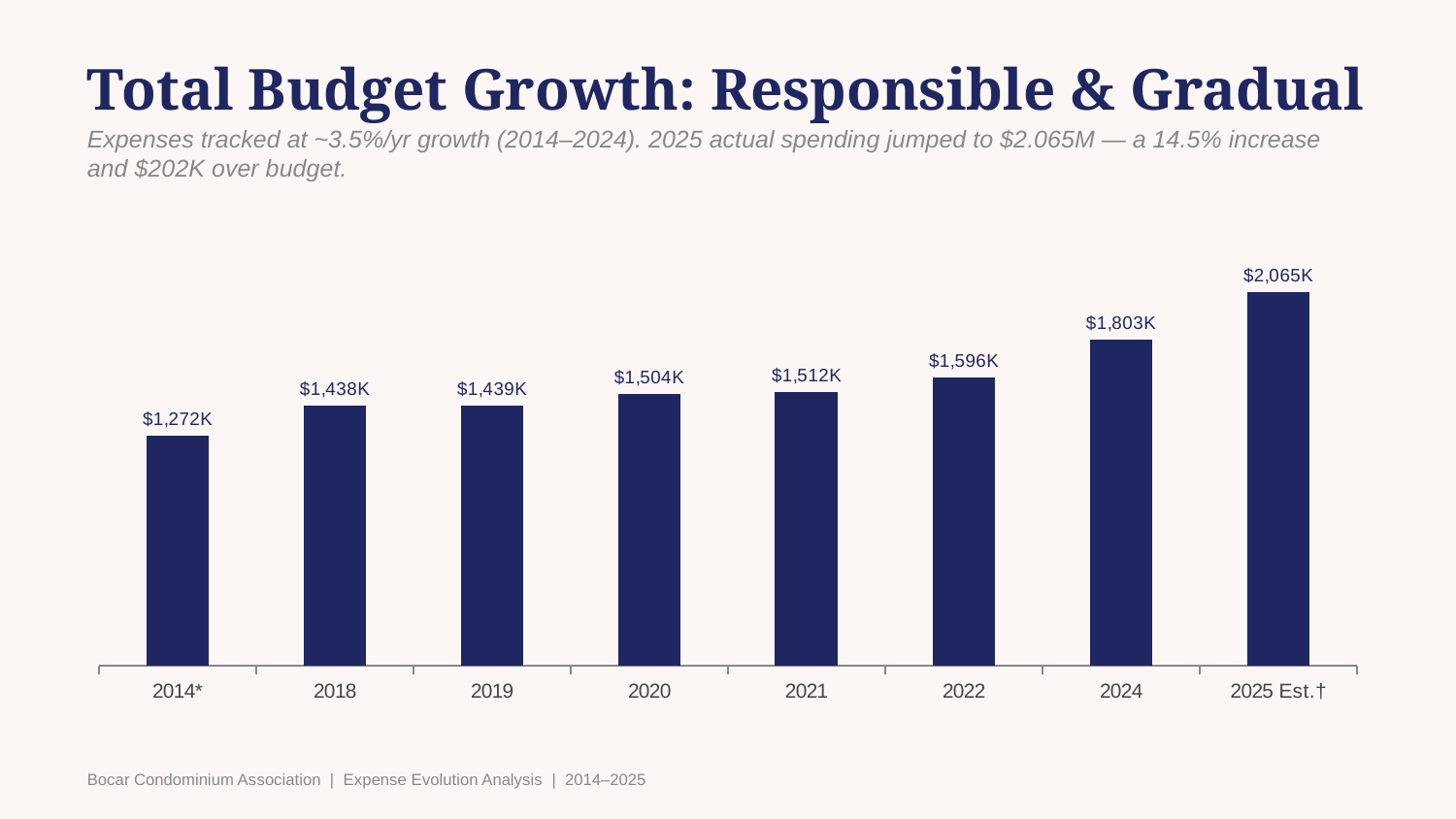
Do the values rise or fall from 2014* to 2025 Est.†? Rise What kind of chart is shown on the slide? Bar chart What is the value for 2022? $1,596K What is the value for 2014*? $1,272K What is the value for 2025 Est.†? $2,065K What is the difference between the values for 2018 and 2014*? $166K Which year has the lowest value? 2014* Which year has the highest value? 2025 Est.† How many years are shown on the x axis? 8 Which is larger, the value for 2024 or the value for 2022? 2024 What is the value for 2020? $1,504K What is the difference between the values for 2025 Est.† and 2024? $262K